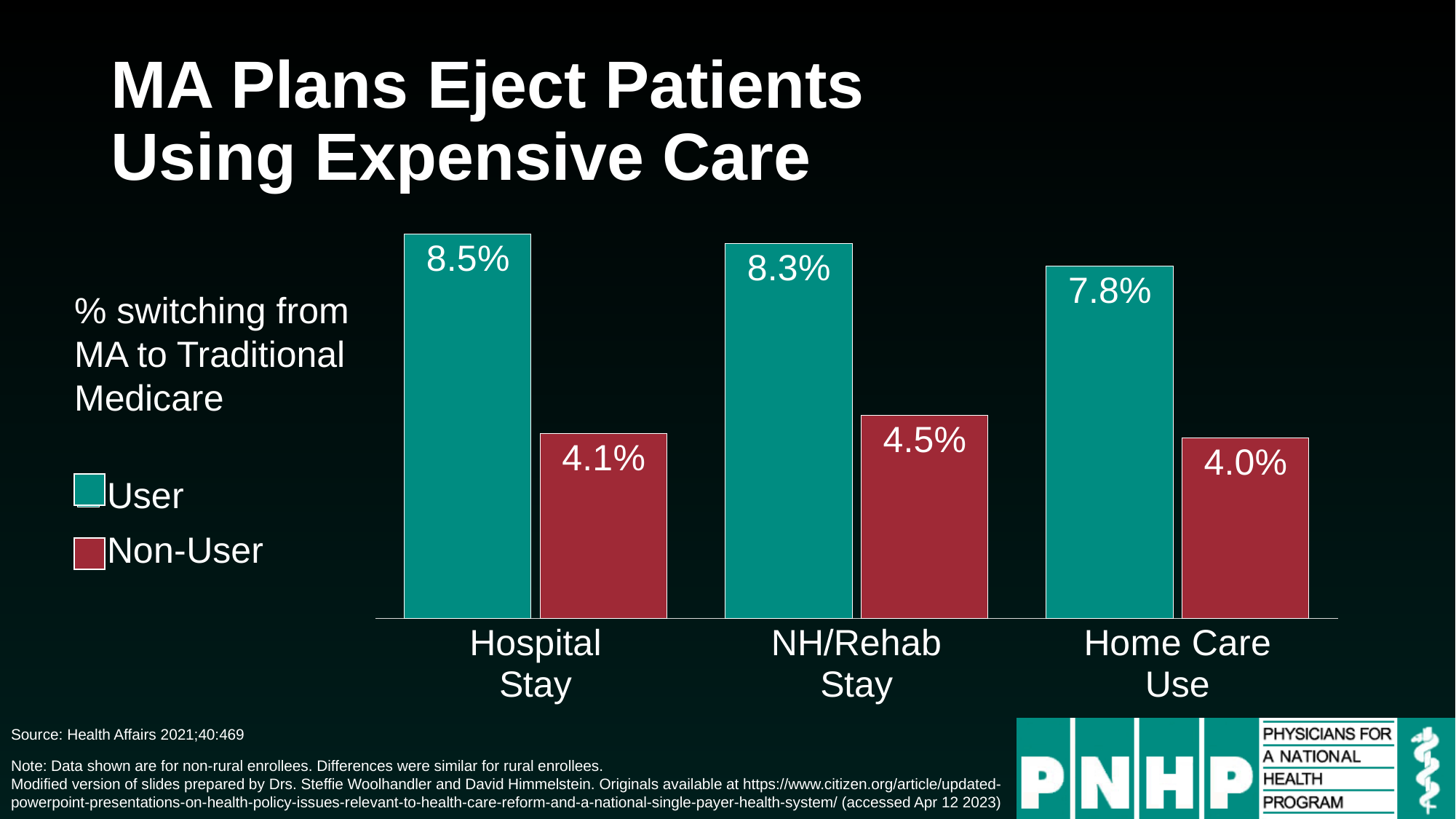
What is the difference between the User and Non-User values for Hospital Stay? 4.4% What is the Non-User value for Home Care Use? 4.0% What is the Non-User value for NH/Rehab Stay? 4.5% How many series does the legend list? 2 What is the difference between the User and Non-User values for NH/Rehab Stay? 3.8% How many categories are shown on the x axis? 3 Which category has the lowest Non-User value? Home Care Use What percentage of Hospital Stay users switched from MA to Traditional Medicare? 8.5% What is the User value for Home Care Use? 7.8% Which is larger for Home Care Use, the User value or the Non-User value? User Which category has the highest User value? Hospital Stay What kind of chart is shown on the slide? Bar chart